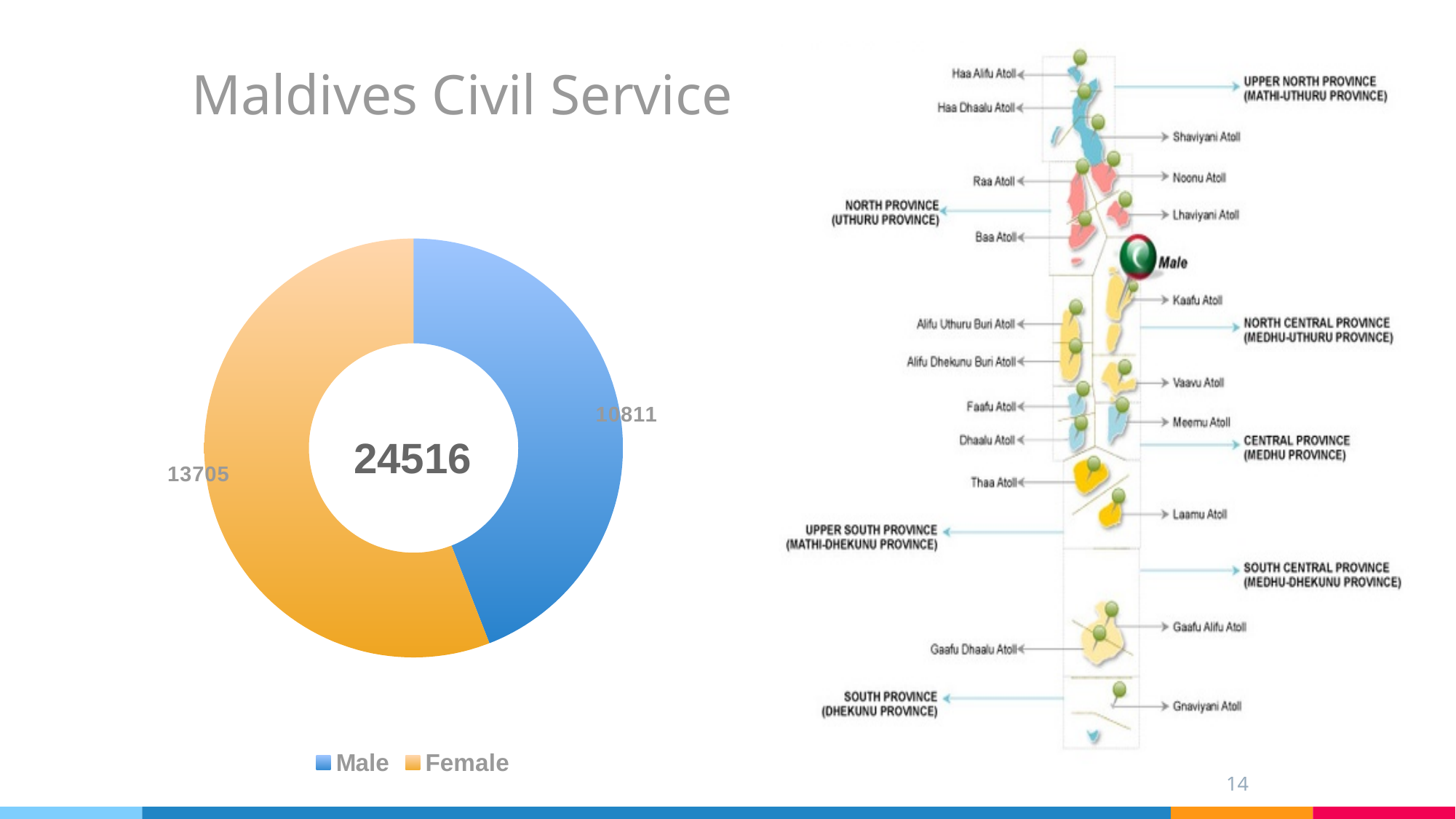
How many categories are shown in the doughnut chart? 2 What is the value for Female in the doughnut chart? 13705 Which category has the larger value in the doughnut chart, Male or Female? Female Which category has the smallest value in the doughnut chart? Male What is the difference between the Female and Male values in the doughnut chart? 2894 What share of the total does the Female slice represent in the doughnut chart? 55.9% What share of the total does the Male slice represent in the doughnut chart? 44.1% What total is shown in the centre of the doughnut chart? 24516 Which colour represents Female in the doughnut chart? Orange Which category has the largest value in the doughnut chart? Female What is the value for Male in the doughnut chart? 10811 What kind of chart is shown on the left of the slide? Doughnut chart